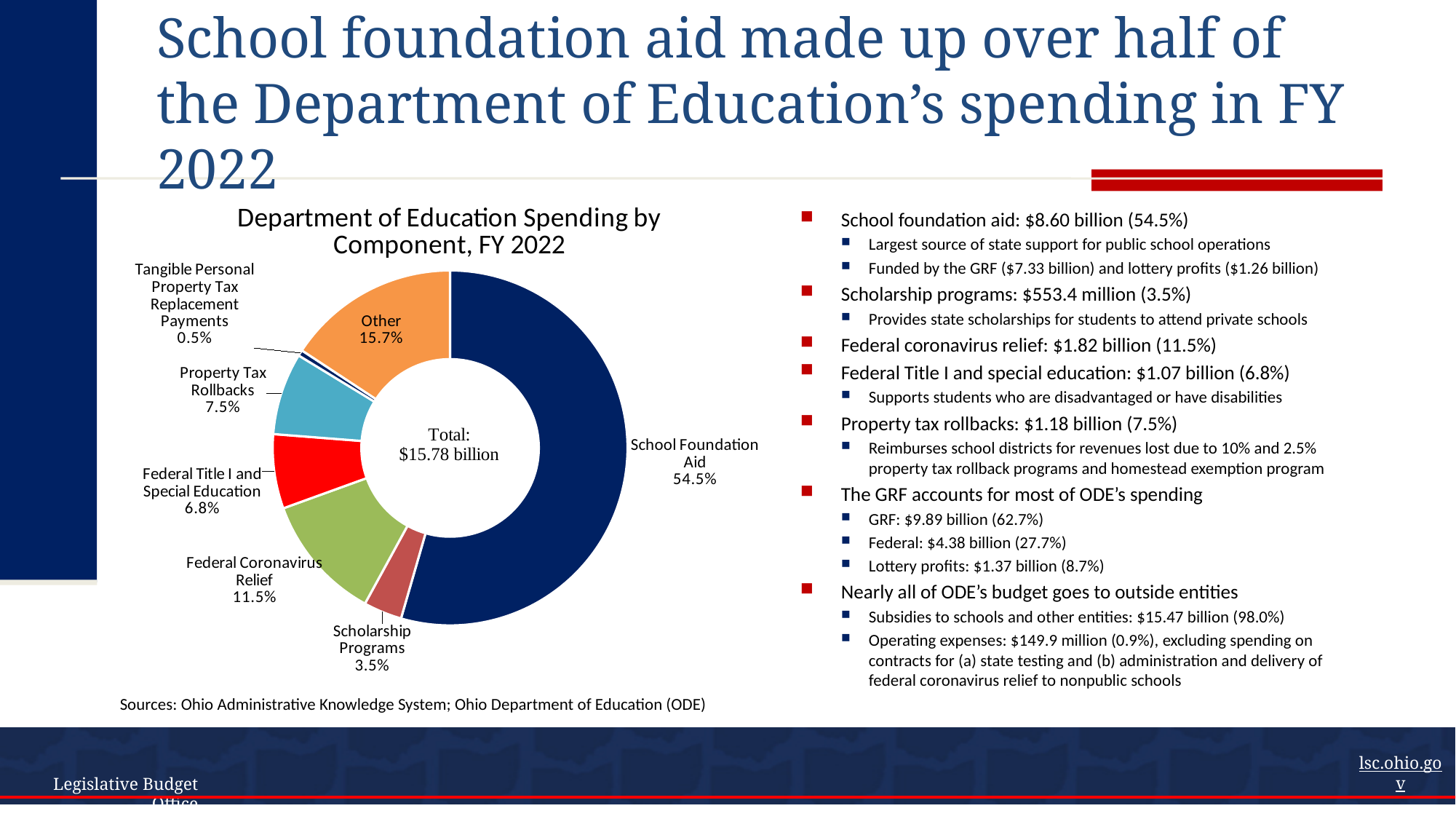
Which component has the largest share in the donut chart? School Foundation Aid What percentage of the donut chart is labelled Other? 15.7% What share of the chart is Scholarship Programs? 3.5% What kind of chart is shown on the slide? Donut (pie) chart What total is printed in the centre of the donut chart? $15.78 billion What is the difference in percentage points between Property Tax Rollbacks and Federal Title I and Special Education? 0.7 percentage points What is the title of the chart? Department of Education Spending by Component, FY 2022 What share does Federal Coronavirus Relief represent in the chart? 11.5% What share of Department of Education spending does School Foundation Aid make up in the donut chart? 54.5% Which is larger in the chart: Federal Coronavirus Relief or Other? Other Which component has the smallest share in the donut chart? Tangible Personal Property Tax Replacement Payments How many components are shown in the donut chart? 7